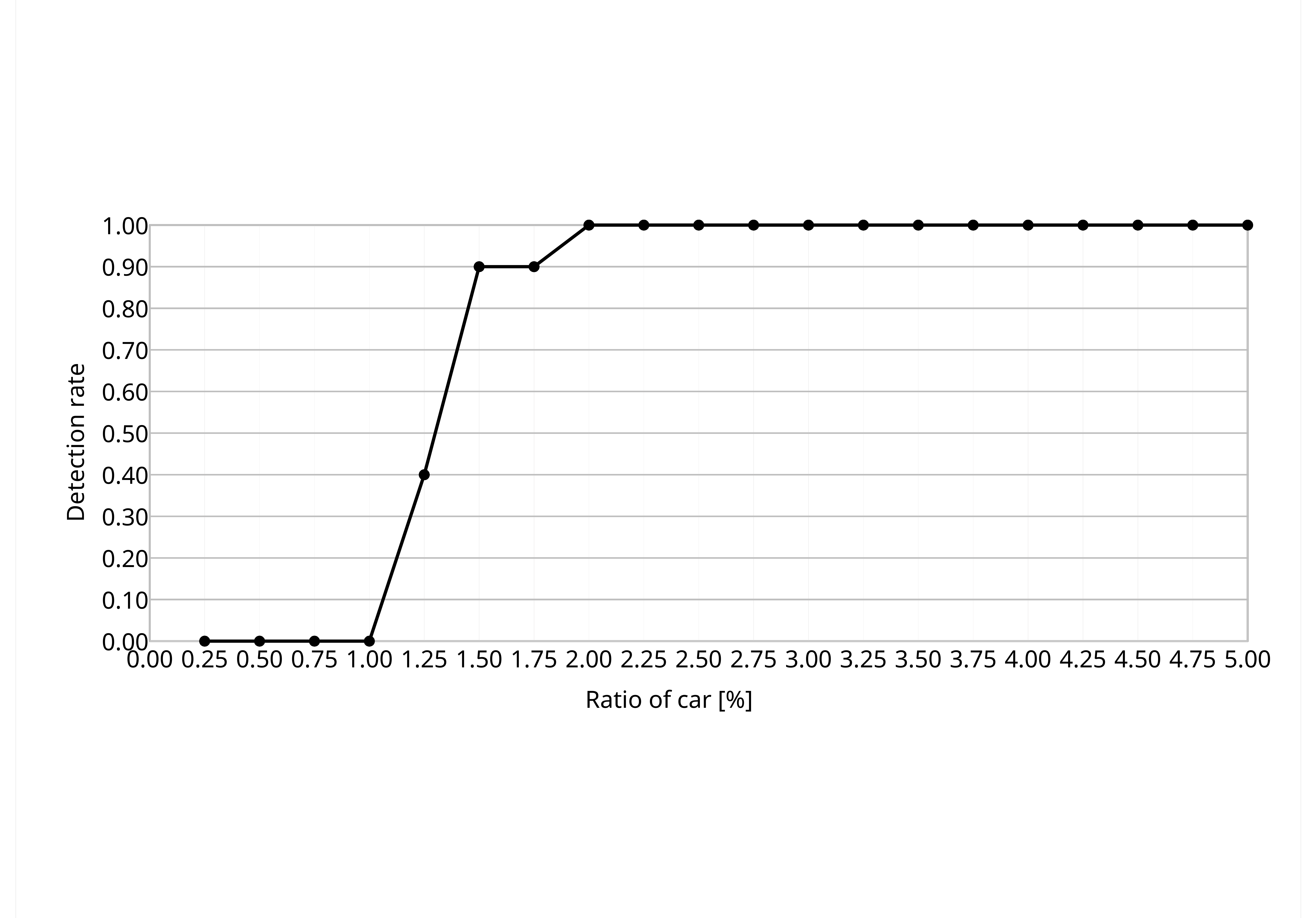
Does the detection rate generally rise or fall as the ratio of car increases? rise Is the detection rate at 1.25% greater or less than 0.50? less Which is larger, the detection rate at 1.25% or at 1.75%? 1.75% What is the detection rate at a ratio of car of 1.00%? 0.00 What is the label of the x axis? Ratio of car [%] What is the difference between the detection rate at 1.50% and at 1.25%? 0.50 What is the detection rate at a ratio of car of 1.25%? 0.40 What is the detection rate at a ratio of car of 1.50%? 0.90 How many data points are plotted on the chart? 20 What is the label of the y axis? Detection rate What is the detection rate at a ratio of car of 2.00%? 1.00 What type of chart is shown on the slide? line chart